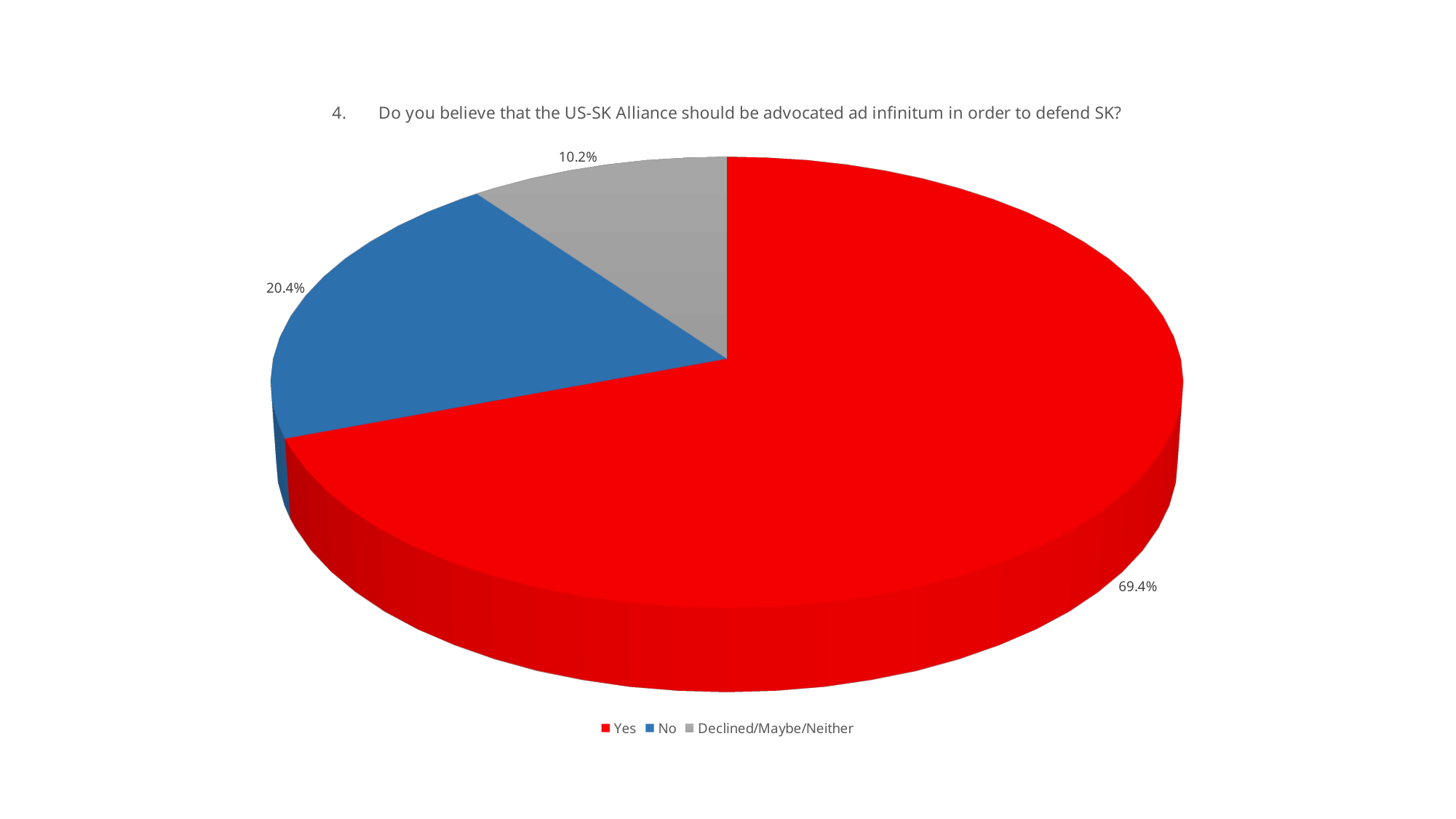
What kind of chart is shown on the slide? Pie chart What percentage of respondents answered No? 20.4% What is the title of the chart? 4. Do you believe that the US-SK Alliance should be advocated ad infinitum in order to defend SK? Which response has the smallest share of the pie? Declined/Maybe/Neither What percentage of respondents answered Yes? 69.4% Which is larger, the No share or the Declined/Maybe/Neither share? No How many categories does the pie chart show? 3 What is the combined share of the No and Declined/Maybe/Neither slices? 30.6% What percentage of respondents are in the Declined/Maybe/Neither category? 10.2% Which response has the largest share of the pie? Yes What colour is the Yes slice? Red What is the difference in percentage points between the Yes and No shares? 49.0